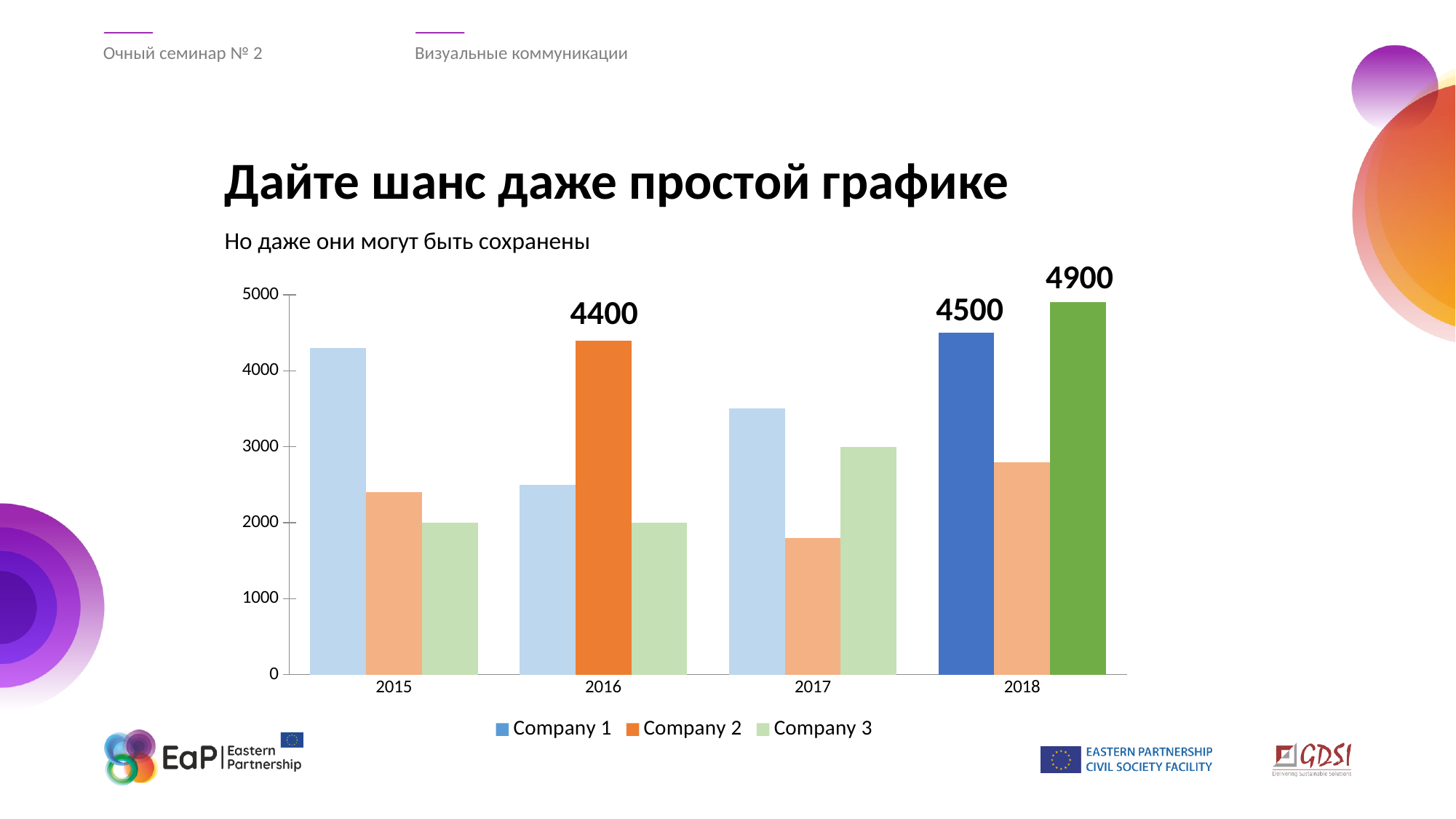
What is the value for Company 2 in 2016? 4400 Which is larger: Company 1 in 2018 or Company 2 in 2016? Company 1 in 2018 How many series does the legend list? 3 How many years are shown on the x axis? 4 Is the value for Company 1 in 2015 greater or less than 4000? greater What is the value for Company 3 in 2018? 4900 What is the value for Company 1 in 2018? 4500 Is the value for Company 2 in 2017 greater or less than 2000? less What is the difference between Company 3 and Company 1 in 2018? 400 What kind of chart is shown on the slide? bar chart In which year is the Company 2 bar the lowest? 2017 Which company has the tallest bar in 2018? Company 3